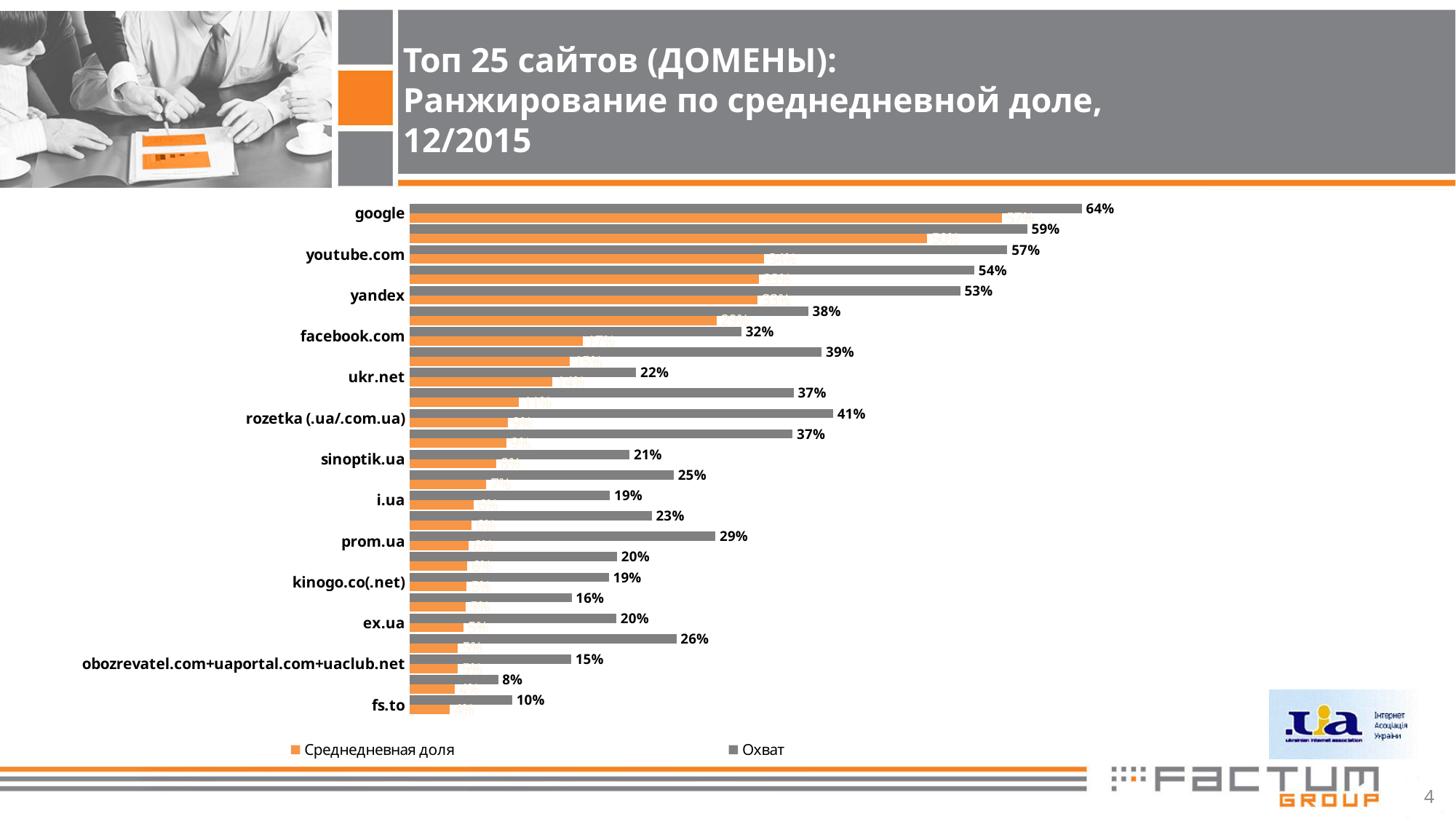
What is the Охват value for prom.ua? 29% What is the Охват value for facebook.com? 32% What is the Охват value for yandex? 53% What is the Охват value for rozetka (.ua/.com.ua)? 41% What kind of chart is shown on the slide? bar chart What is the Охват value for youtube.com? 57% Which site has the highest Охват value? google What is the difference between the Охват values for google and youtube.com? 7% How many series does the legend list? 2 What is the Охват value for google? 64% What is the Охват value for fs.to? 10% Which has a larger Охват value, rozetka (.ua/.com.ua) or facebook.com? rozetka (.ua/.com.ua)